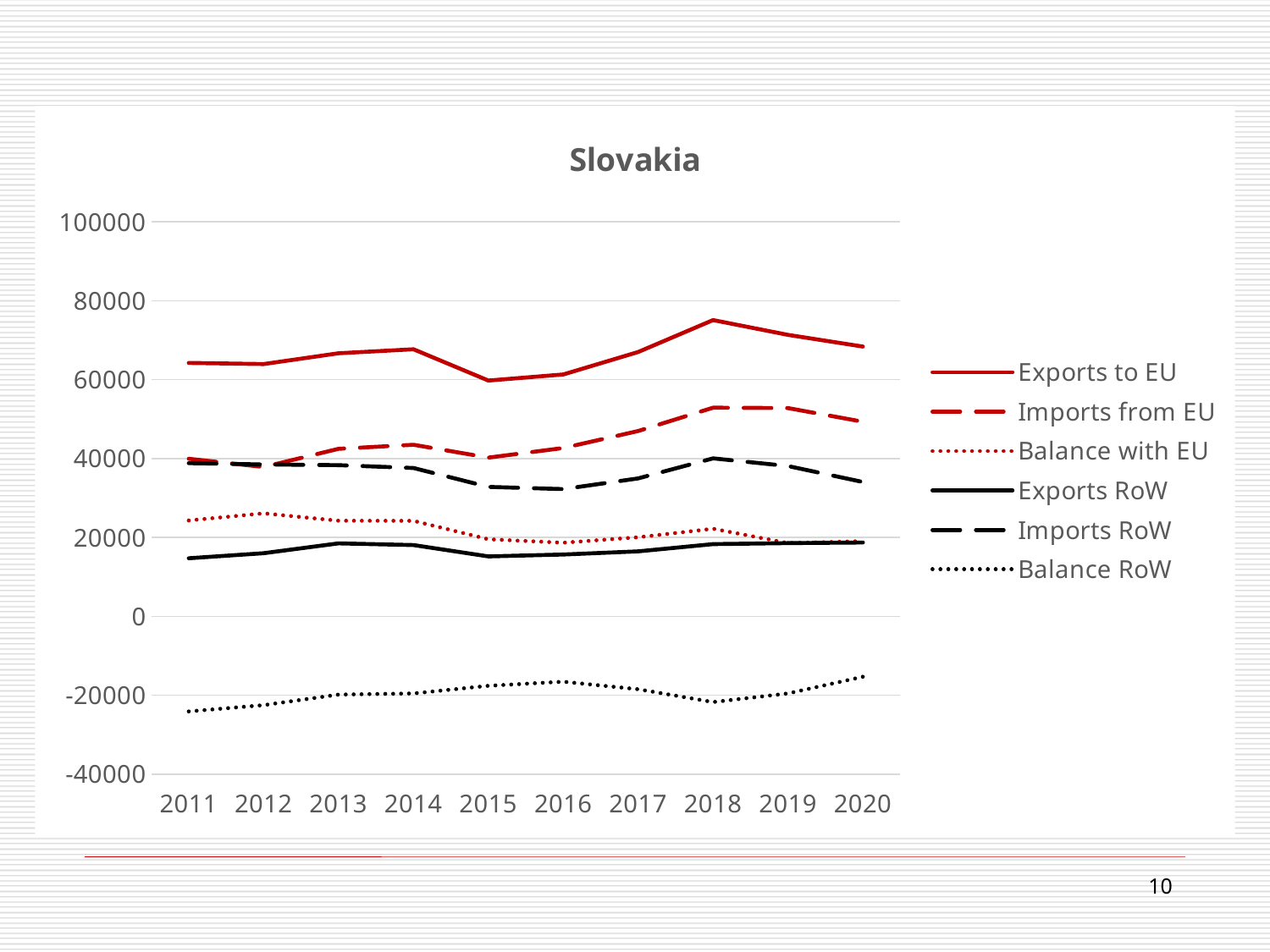
Does Balance RoW rise or fall from 2018 to 2020? rise In 2015, which is larger, Imports RoW or Exports RoW? Imports RoW Is the value for Balance RoW in 2011 greater or less than -20000? less How many years are shown on the x axis? 10 What is the title of the chart? Slovakia In 2020, which is larger, Exports to EU or Imports from EU? Exports to EU Is the value for Exports RoW in 2011 greater or less than 20000? less In which year is Balance RoW at its highest? 2020 What kind of chart is shown on the slide? line chart How many series does the legend list? 6 In which year is Exports to EU at its highest? 2018 Is the value for Exports to EU in 2018 greater or less than 60000? greater